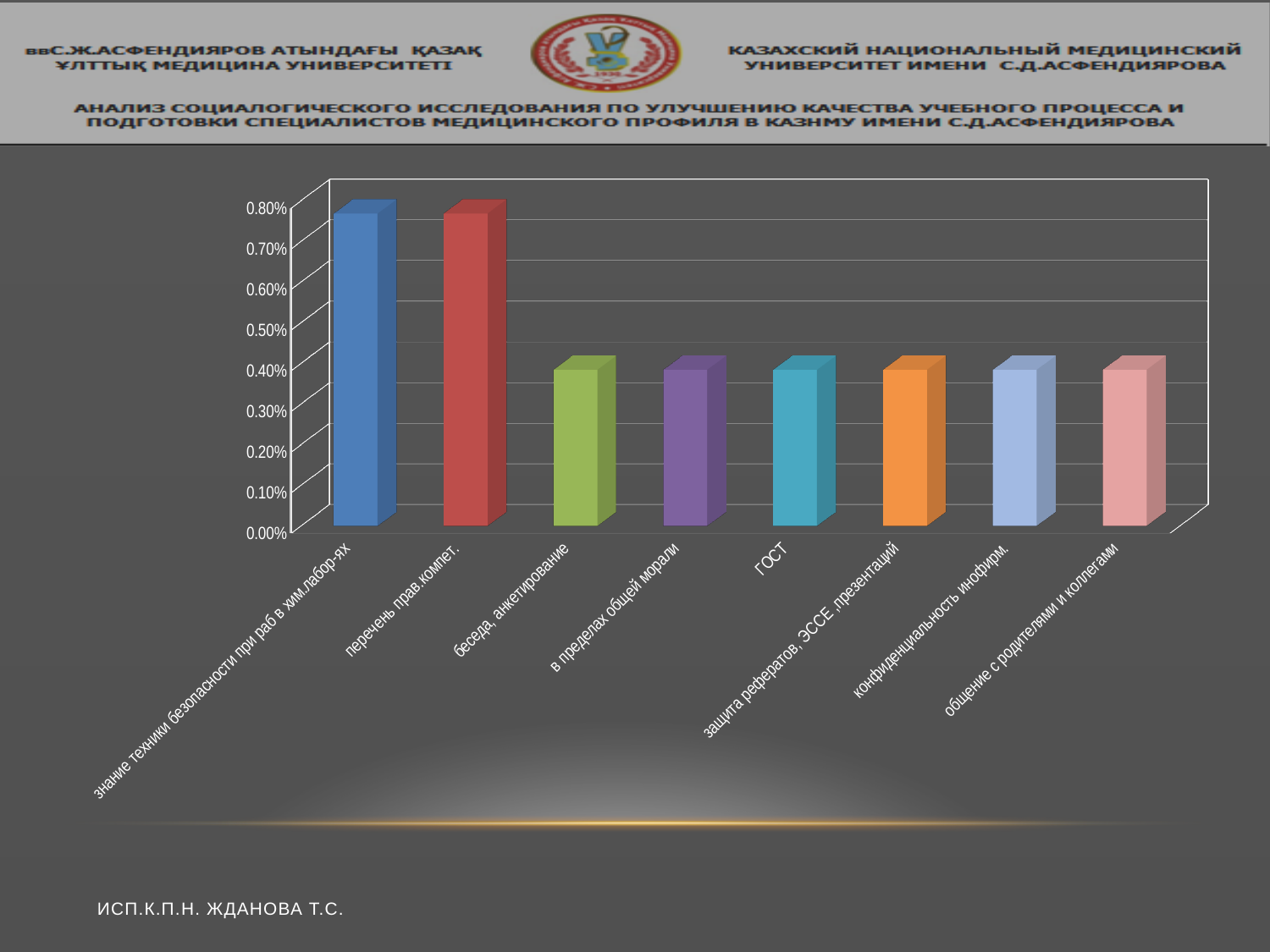
What is the highest value shown on the vertical axis of the chart? 0.80% Is the value for "перечень прав,компет." greater or less than 0.50%? greater Is the value for "ГОСТ" greater or less than 0.60%? less What is the label of the fifth category on the x axis? ГОСТ Is the value for "общение с родителями и коллегами" greater or less than 0.20%? greater Which is larger: the value for "перечень прав,компет." or the value for "конфиденциальность инофирм."? перечень прав,компет. What kind of chart is shown on the slide? bar chart How many categories (bars) does the chart show? 8 Which is larger: the value for "в пределах общей морали" or the value for "знание техники безопасности при раб в хим.лабор-ях"? знание техники безопасности при раб в хим.лабор-ях